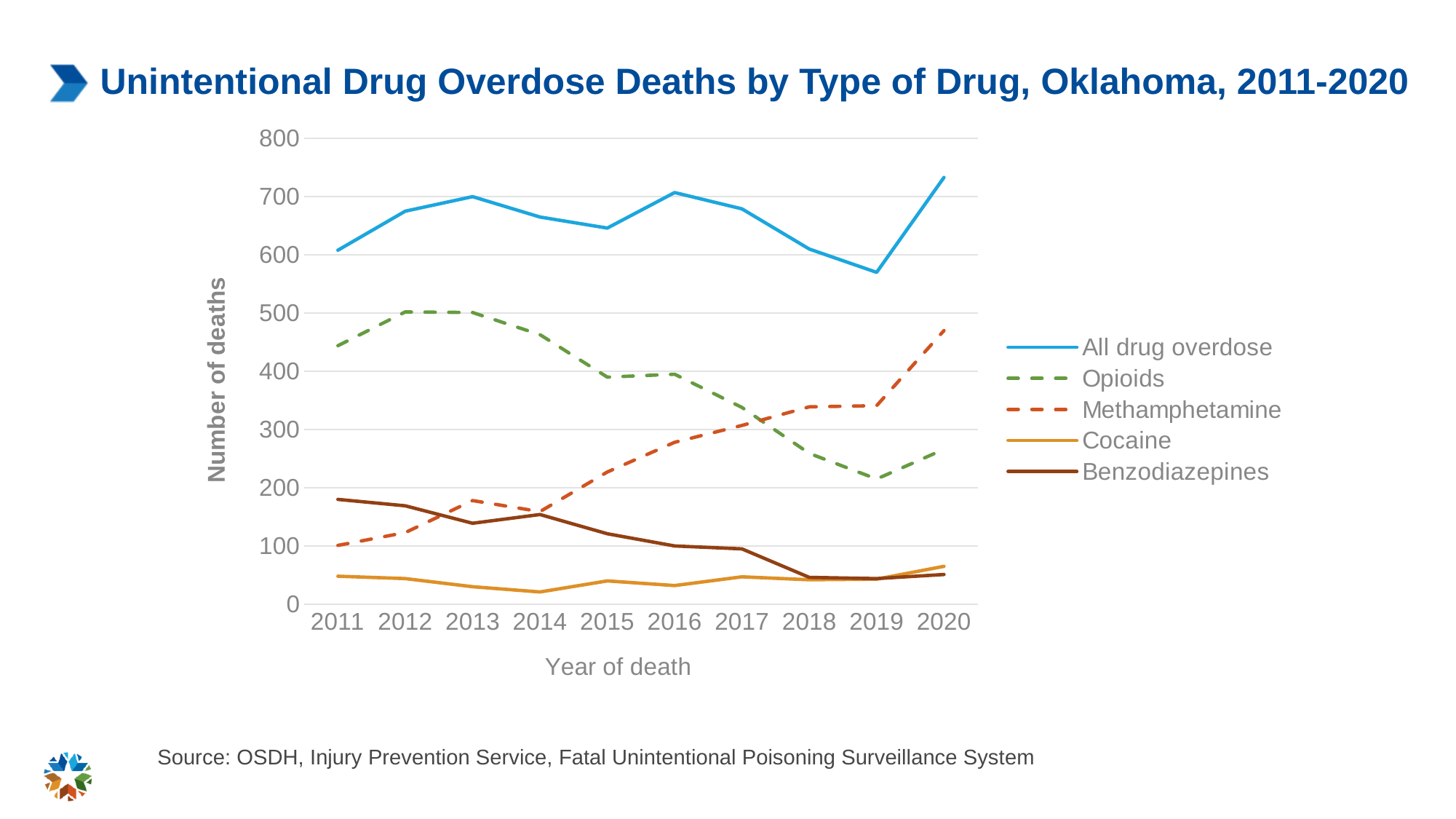
What kind of chart is shown on the slide? Line chart Does the Benzodiazepines line rise or fall from 2011 to 2020? Fall How many years are plotted along the x axis? 10 How many series does the legend list? 5 In which year is the All drug overdose line at its lowest? 2019 Is the value for All drug overdose in 2019 greater or less than 600? less In 2020, which is higher: Methamphetamine or Opioids? Methamphetamine In which year is the Opioids line at its lowest? 2019 Is the value for Opioids in 2013 greater or less than 400? greater What is the title of the x axis? Year of death Is the value for Methamphetamine in 2011 greater or less than 200? less In which year is the All drug overdose line at its highest? 2020